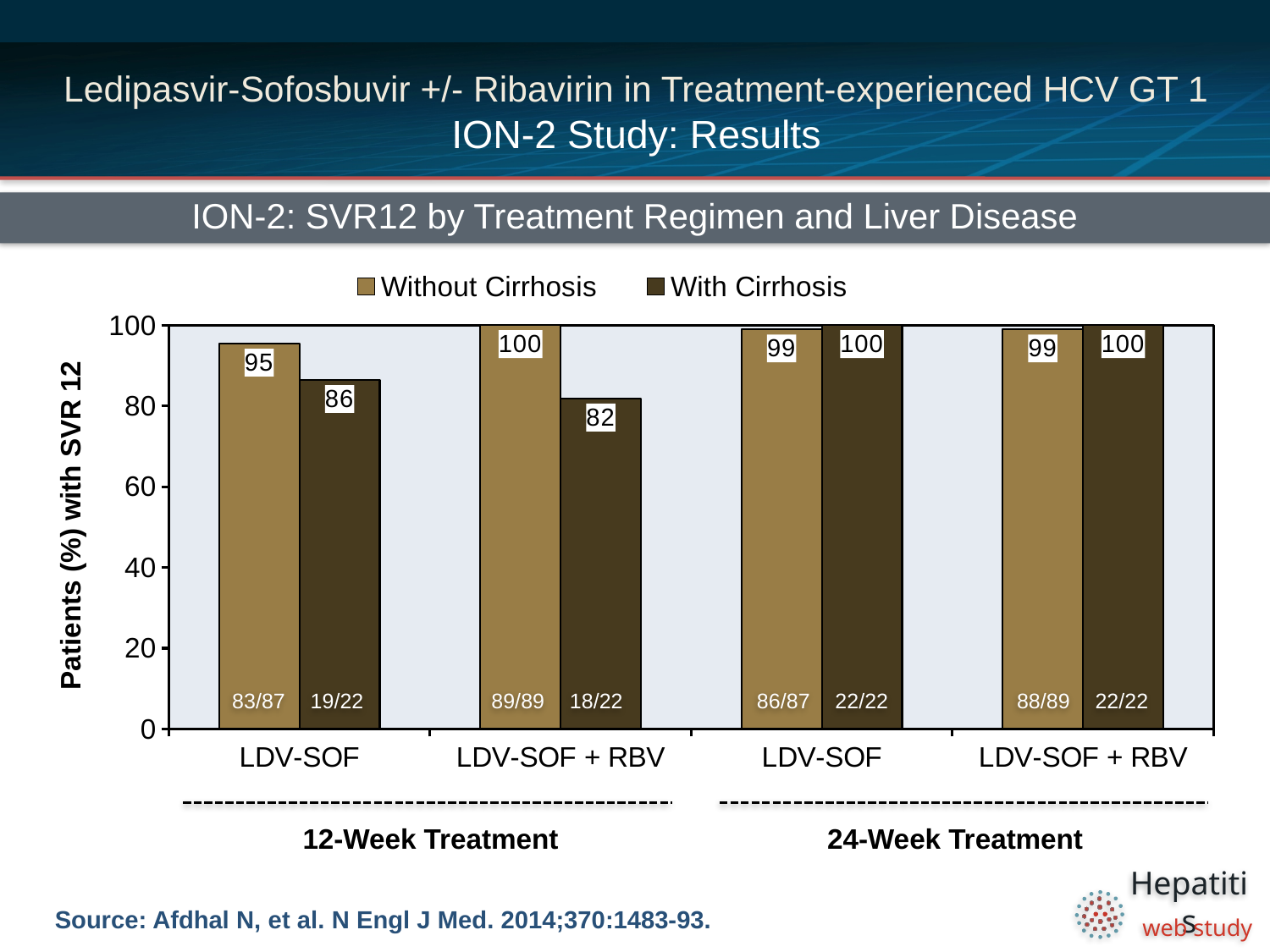
What is the SVR12 rate for patients with cirrhosis receiving LDV-SOF + RBV in the 12-week treatment group? 82 How many patients with cirrhosis achieved SVR12 with LDV-SOF in the 12-week treatment group, as shown by the fraction on the bar? 19/22 What is the SVR12 rate for patients with cirrhosis receiving LDV-SOF in the 24-week treatment group? 100 What is the label of the y axis of the chart? Patients (%) with SVR 12 What type of chart is shown on the slide? Bar chart What is the SVR12 rate for patients without cirrhosis receiving LDV-SOF in the 12-week treatment group? 95 In the 12-week LDV-SOF group, which has the higher SVR12 rate: patients without cirrhosis or with cirrhosis? Without Cirrhosis How many series does the chart legend list? 2 Which bar shows the lowest SVR12 rate on the chart? With Cirrhosis, LDV-SOF + RBV, 12-Week Treatment What is the difference in SVR12 rate between patients without cirrhosis and with cirrhosis receiving LDV-SOF + RBV in the 12-week treatment group? 18 How many treatment regimen categories are shown on the x axis of the chart? 4 What is the difference in SVR12 rate between patients without cirrhosis and with cirrhosis receiving LDV-SOF in the 12-week treatment group? 9